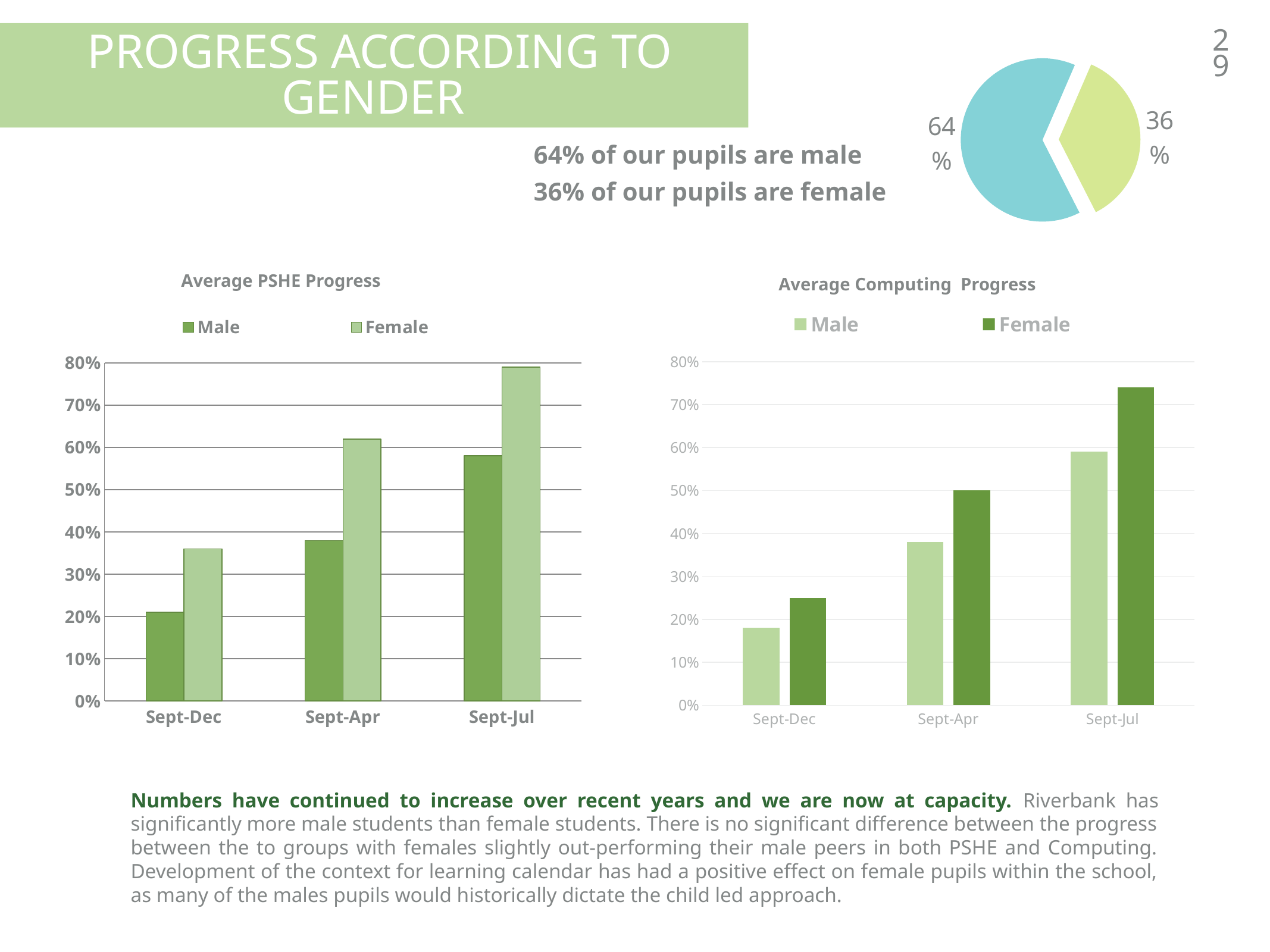
In the Average PSHE Progress chart, is the Female value for Sept-Dec greater or less than 30%? greater How many categories are shown on the x axis of the Average Computing Progress chart? 3 What kind of chart is the Average PSHE Progress chart? Bar chart In the Average Computing Progress chart, do the Male values rise or fall from Sept-Dec to Sept-Jul? Rise In the Average Computing Progress chart, which is larger for Sept-Jul, Male or Female? Female How many series does the legend of the Average PSHE Progress chart list? 2 In the Average PSHE Progress chart, is the Male value for Sept-Jul greater or less than 60%? less In the Average Computing Progress chart, is the Male value for Sept-Dec greater or less than 20%? less In the pie chart at the top right, which slice is larger, male or female? Male In the pie chart at the top right, what share of pupils is male? 64% In the Average PSHE Progress chart, which period has the highest Female value? Sept-Jul In the pie chart at the top right, what share of pupils is female? 36%